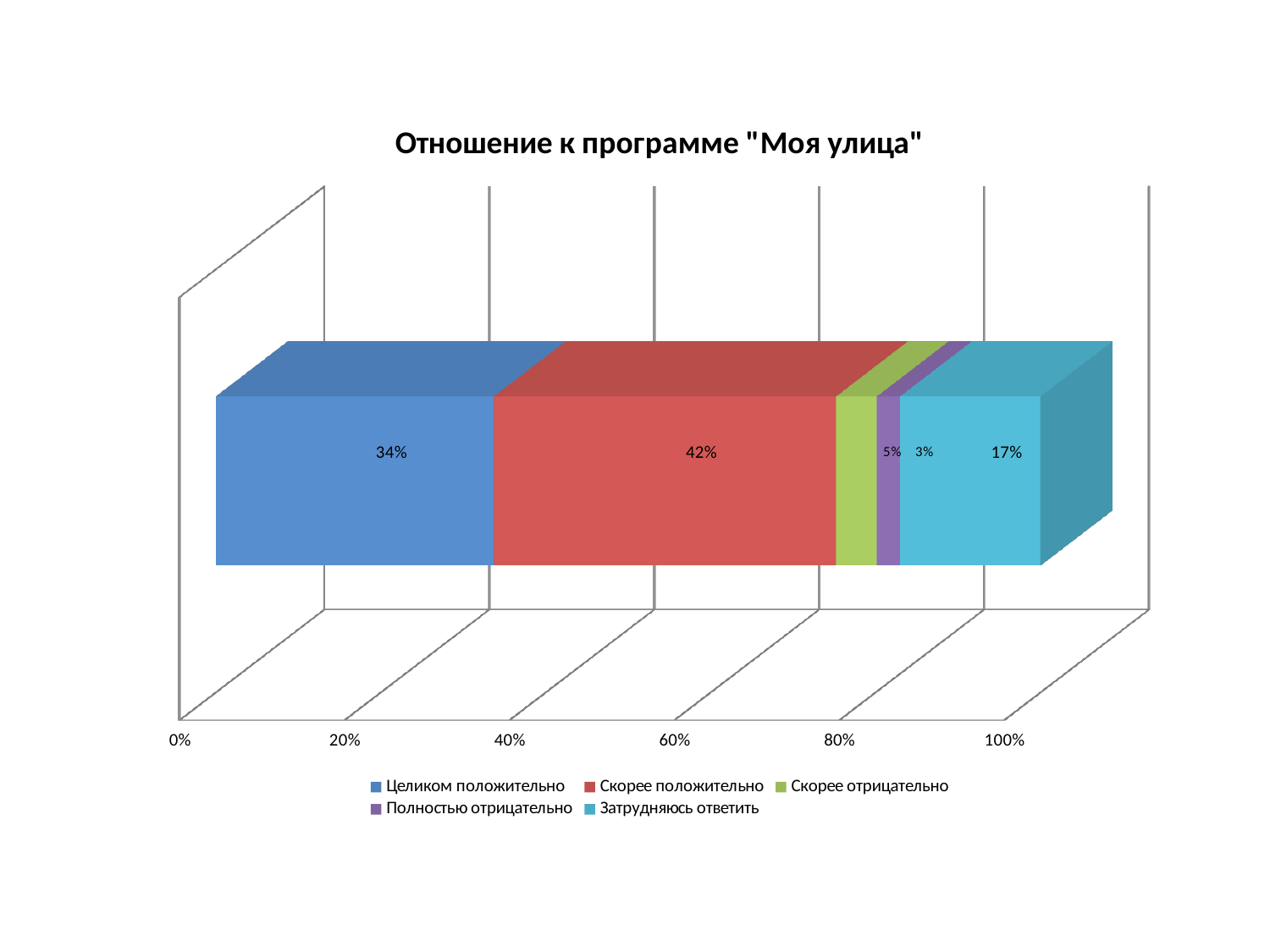
Which response category has the highest value? Скорее положительно What is the value for "Полностью отрицательно"? 3% How many series does the legend list? 5 What kind of chart is shown on the slide? Stacked bar chart What percentage of respondents answered "Целиком положительно"? 34% What share of respondents answered "Затрудняюсь ответить"? 17% What is the title of the chart? Отношение к программе "Моя улица" What is the value for "Скорее положительно"? 42% What is the difference between "Скорее положительно" and "Целиком положительно"? 8% Which response category has the lowest value? Полностью отрицательно Which is larger: "Затрудняюсь ответить" or "Скорее отрицательно"? Затрудняюсь ответить What is the value for "Скорее отрицательно"? 5%